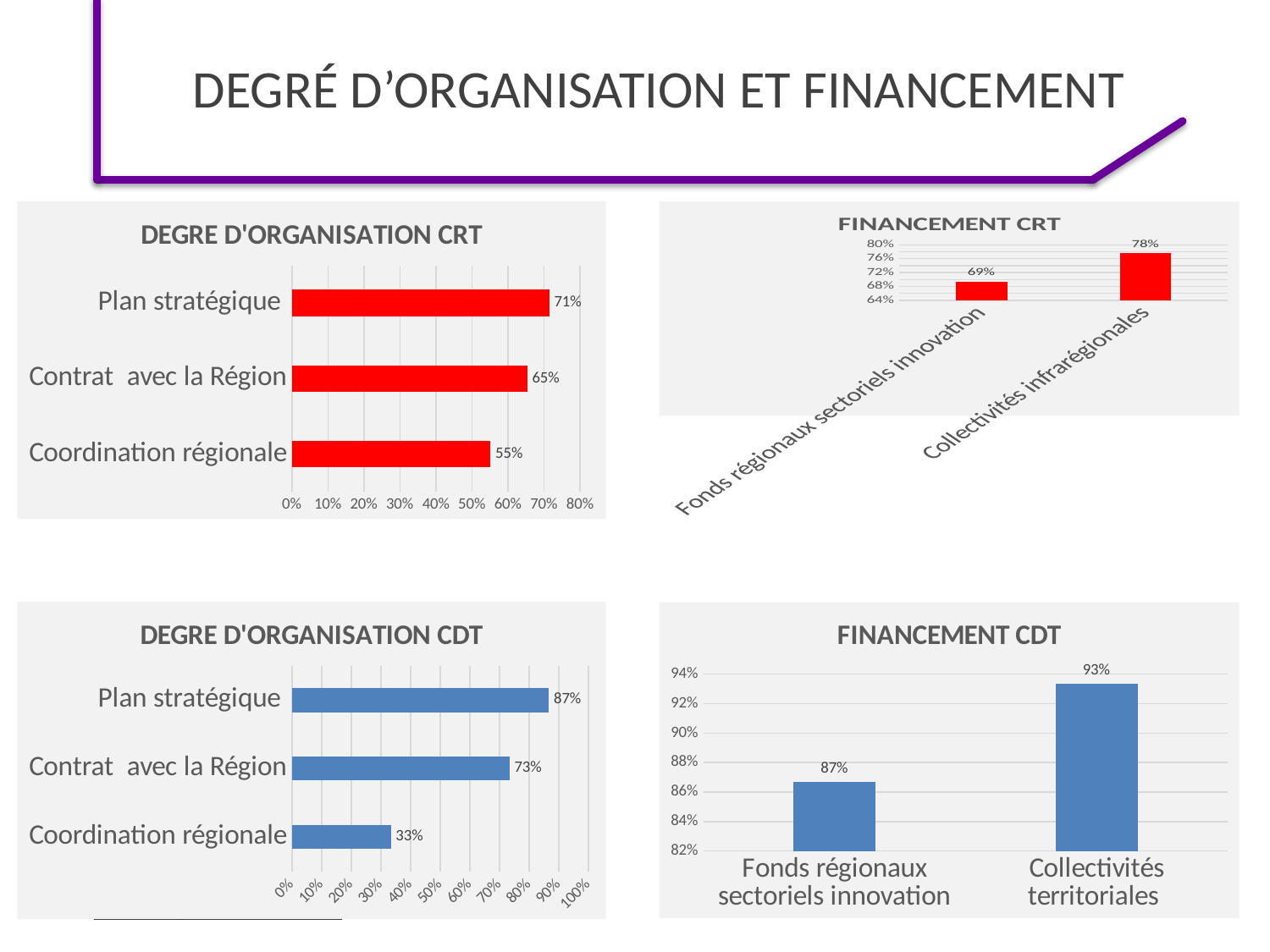
What kind of chart is the 'FINANCEMENT CDT' chart? Bar chart In the 'FINANCEMENT CRT' chart, which is larger: Fonds régionaux sectoriels innovation or Collectivités infrarégionales? Collectivités infrarégionales In the 'DEGRE D'ORGANISATION CDT' chart, which category has the highest value? Plan stratégique In the 'FINANCEMENT CDT' chart, what is the value for Fonds régionaux sectoriels innovation? 87% How many categories does the 'DEGRE D'ORGANISATION CDT' chart show? 3 In the 'DEGRE D'ORGANISATION CRT' chart, what is the difference between Plan stratégique and Coordination régionale? 16% In the 'DEGRE D'ORGANISATION CRT' chart, what is the value for Plan stratégique? 71% In the 'DEGRE D'ORGANISATION CRT' chart, which category has the lowest value? Coordination régionale In the 'FINANCEMENT CDT' chart, what is the difference between Collectivités territoriales and Fonds régionaux sectoriels innovation? 6% In the 'DEGRE D'ORGANISATION CDT' chart, what is the value for Coordination régionale? 33% In the 'FINANCEMENT CRT' chart, what is the value for Collectivités infrarégionales? 78% In the 'DEGRE D'ORGANISATION CDT' chart, what is the difference between Contrat avec la Région and Coordination régionale? 40%